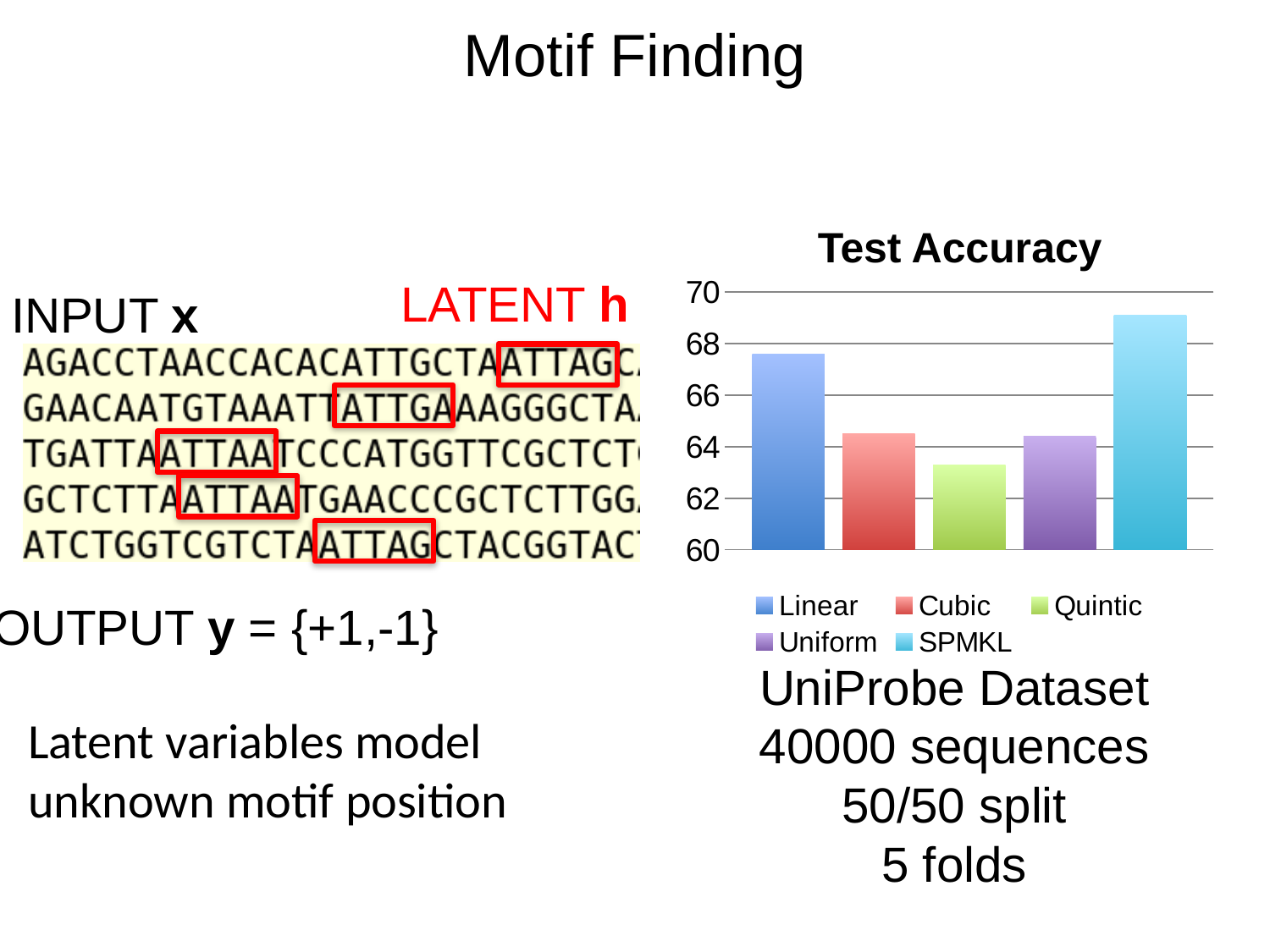
Which has a higher test accuracy, Quintic or Uniform? Uniform How many series does the legend of the Test Accuracy chart list? 5 Which series has the lowest test accuracy in the chart? Quintic How many bars are plotted in the Test Accuracy chart? 5 What is the title of the chart on the slide? Test Accuracy Is the test accuracy for SPMKL greater or less than 68? greater Is the test accuracy for Quintic greater or less than 64? less What kind of chart is shown under the title "Test Accuracy"? bar chart Is the test accuracy for Linear greater or less than 66? greater Which has a higher test accuracy, Linear or Cubic? Linear Which series has the highest test accuracy in the chart? SPMKL What colour is the bar for SPMKL in the Test Accuracy chart? light blue